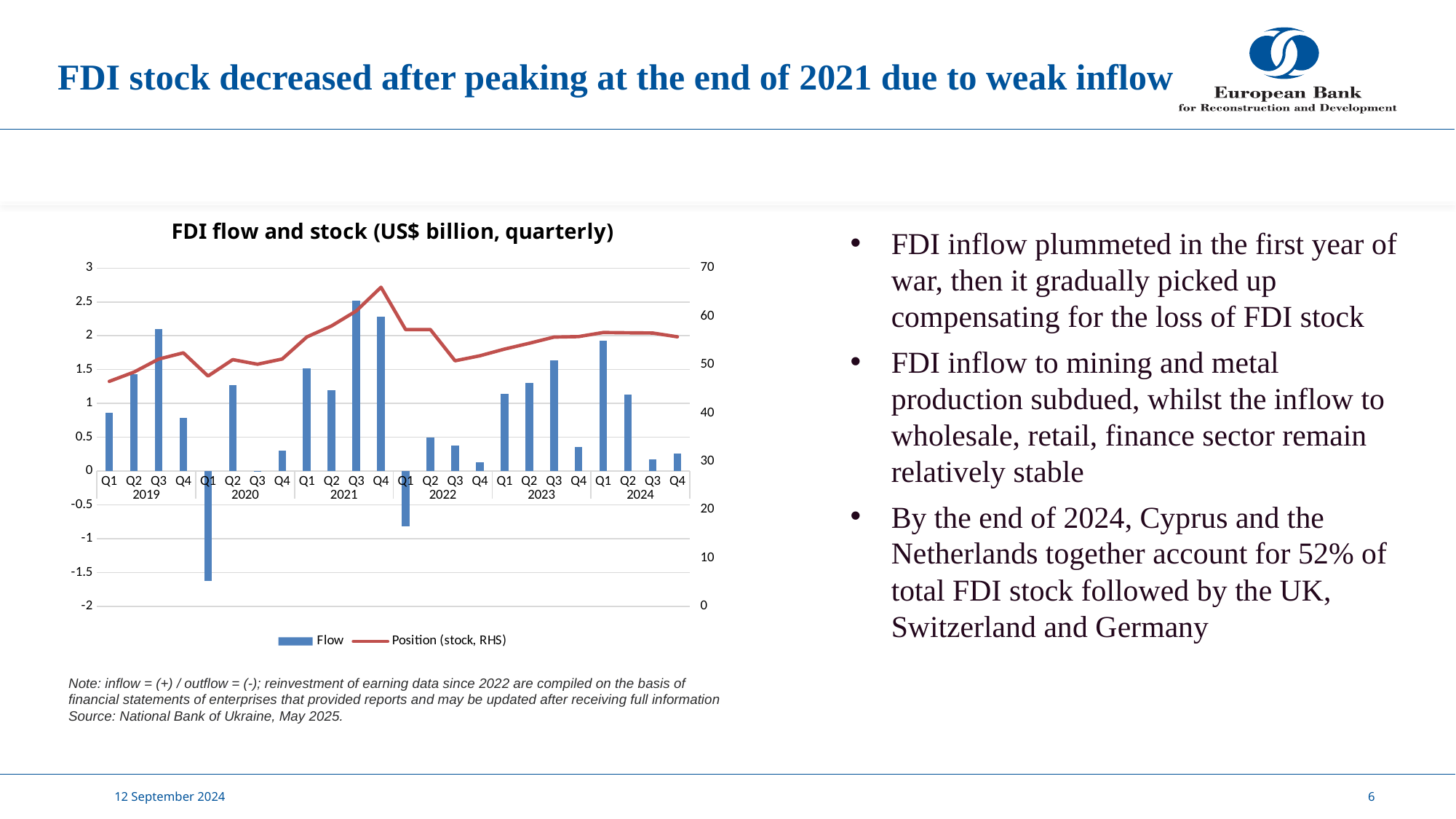
In which quarter does the Position (stock, RHS) line reach its peak? Q4 2021 Which quarter has the larger Flow value, Q1 2024 or Q2 2024? Q1 2024 Is the Flow value for Q4 2021 greater or less than 2? greater In which quarter is the FDI flow bar the lowest? Q1 2020 How many series does the legend of the chart list? 2 Is the Position (stock, RHS) value for Q4 2021 greater or less than 60? greater What is the title of the chart? FDI flow and stock (US$ billion, quarterly) Is the Flow value for Q1 2022 greater or less than -0.5? less What kind of chart is shown on the slide? A combination bar and line chart In which quarter is the FDI flow bar the highest? Q3 2021 How many quarterly categories are plotted on the x axis of the chart? 24